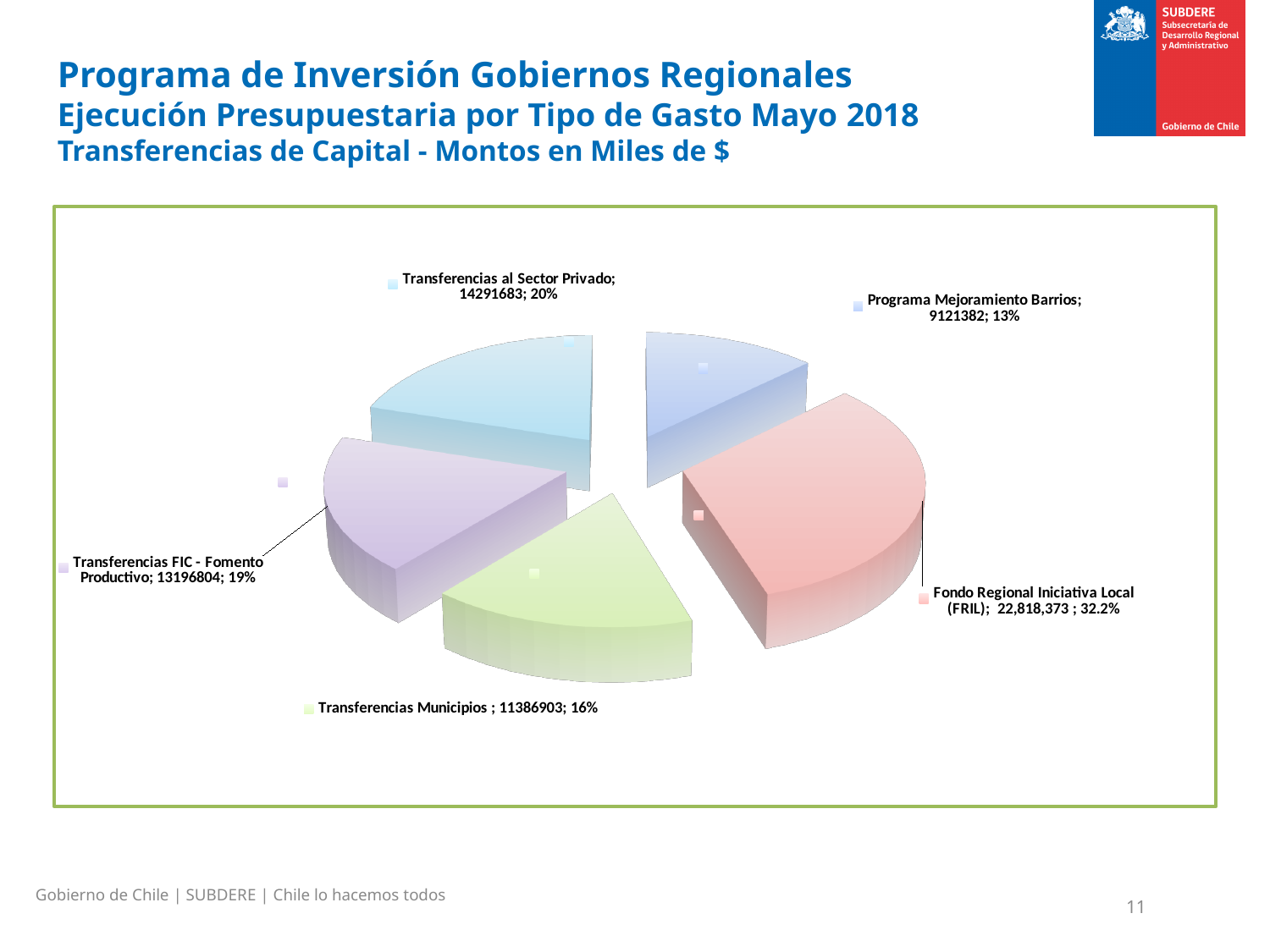
What share of the pie does Transferencias FIC - Fomento Productivo represent? 19% What is the difference between the values for Transferencias al Sector Privado and Transferencias FIC - Fomento Productivo? 1094879 Which category has the smallest slice? Programa Mejoramiento Barrios What kind of chart is shown on the slide? pie chart What is the value for Fondo Regional Iniciativa Local (FRIL)? 22,818,373 What is the value for Transferencias al Sector Privado? 14291683 Which category has the largest slice? Fondo Regional Iniciativa Local (FRIL) What is the value for Programa Mejoramiento Barrios? 9121382 What is the value for Transferencias Municipios? 11386903 What share of the pie does Fondo Regional Iniciativa Local (FRIL) represent? 32.2% How many slices does the pie chart have? 5 Which is larger, Transferencias al Sector Privado or Transferencias Municipios? Transferencias al Sector Privado